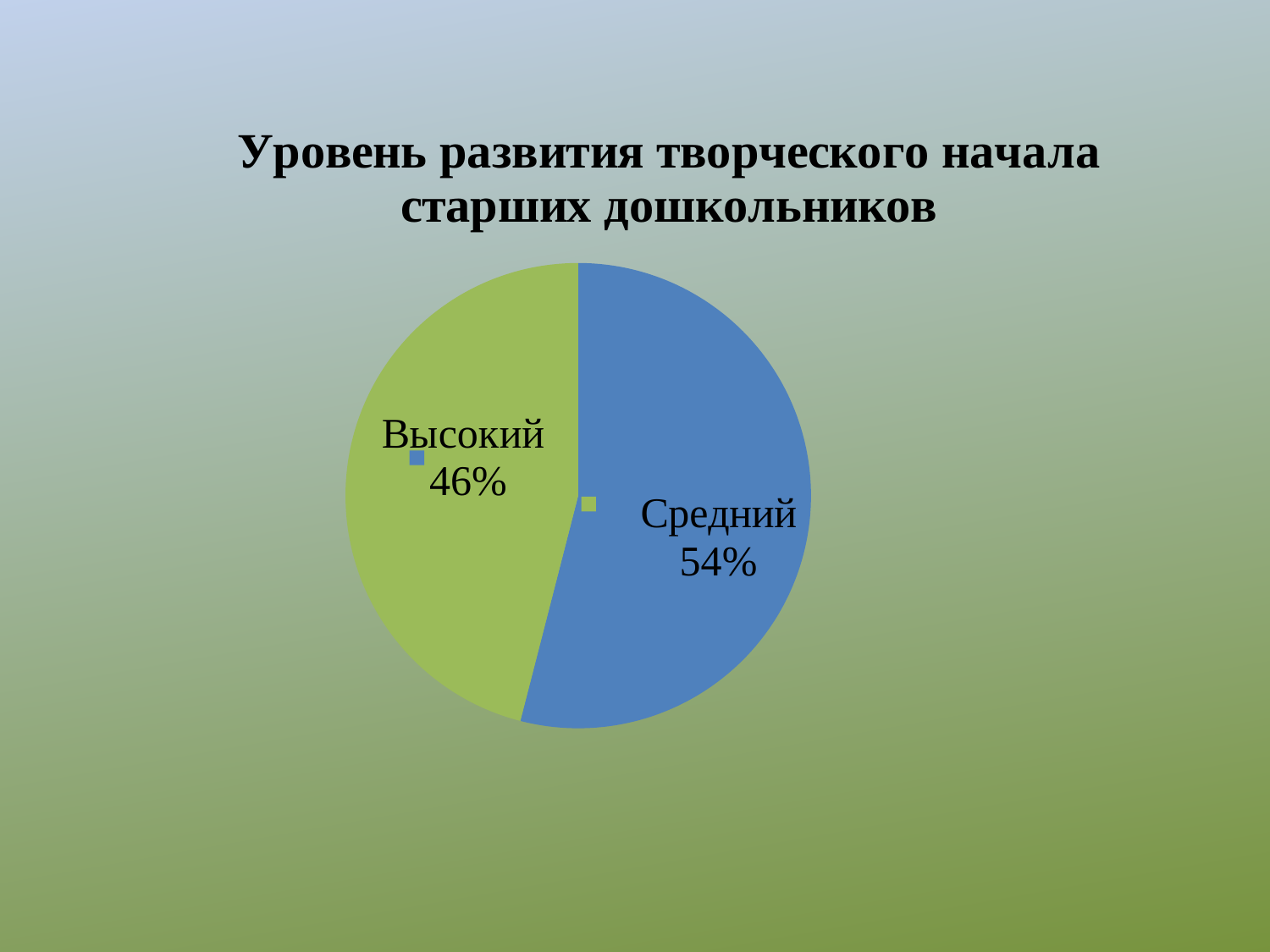
Which slice is larger, Средний or Высокий? Средний Is the value for Высокий greater or less than 50%? less How many slices does the pie chart have? 2 Which category has the largest slice of the pie? Средний What colour is the Средний slice? blue What kind of chart is shown on the slide? pie chart What share of the pie does the Средний slice represent? 54% What is the difference in percentage points between the Средний and Высокий slices? 8 What share of the pie does the Высокий slice represent? 46% Which category has the smallest slice of the pie? Высокий What is the title of the chart? Уровень развития творческого начала старших дошкольников